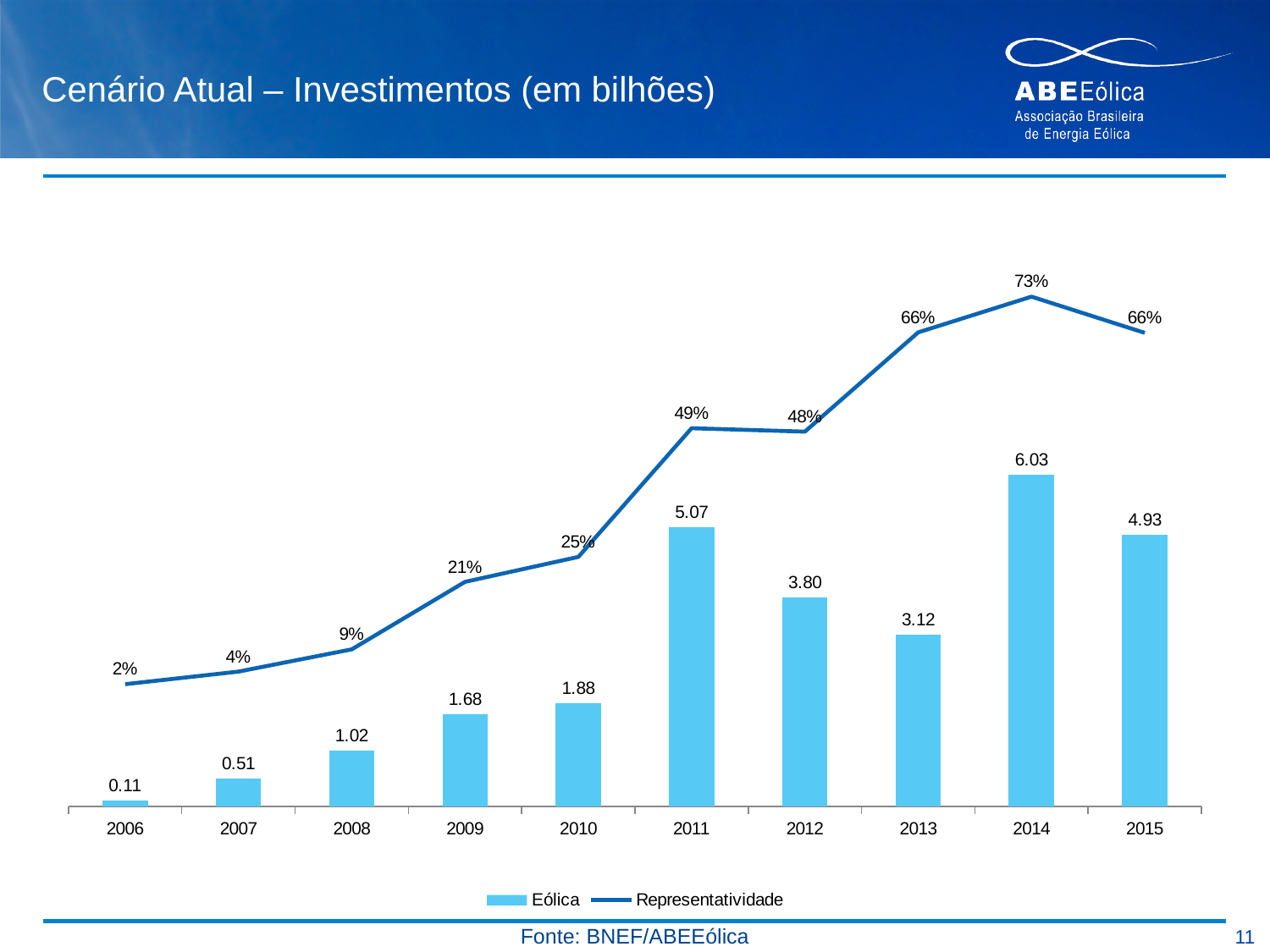
Does the Representatividade line generally rise or fall from 2006 to 2014? Rise What is the Eólica investment value for 2006? 0.11 Which year has the lowest Representatividade value? 2006 What is the Eólica investment value for 2014? 6.03 What is the title of the slide? Cenário Atual – Investimentos (em bilhões) Which year has a larger Eólica value, 2013 or 2015? 2015 What kind of chart is used for the Eólica series? Bar chart What is the difference between the Eólica values for 2011 and 2012? 1.27 How many series does the legend list? 2 How many years are shown on the x axis? 10 What is the Representatividade value for 2011? 49% Which year has the highest Eólica investment value? 2014